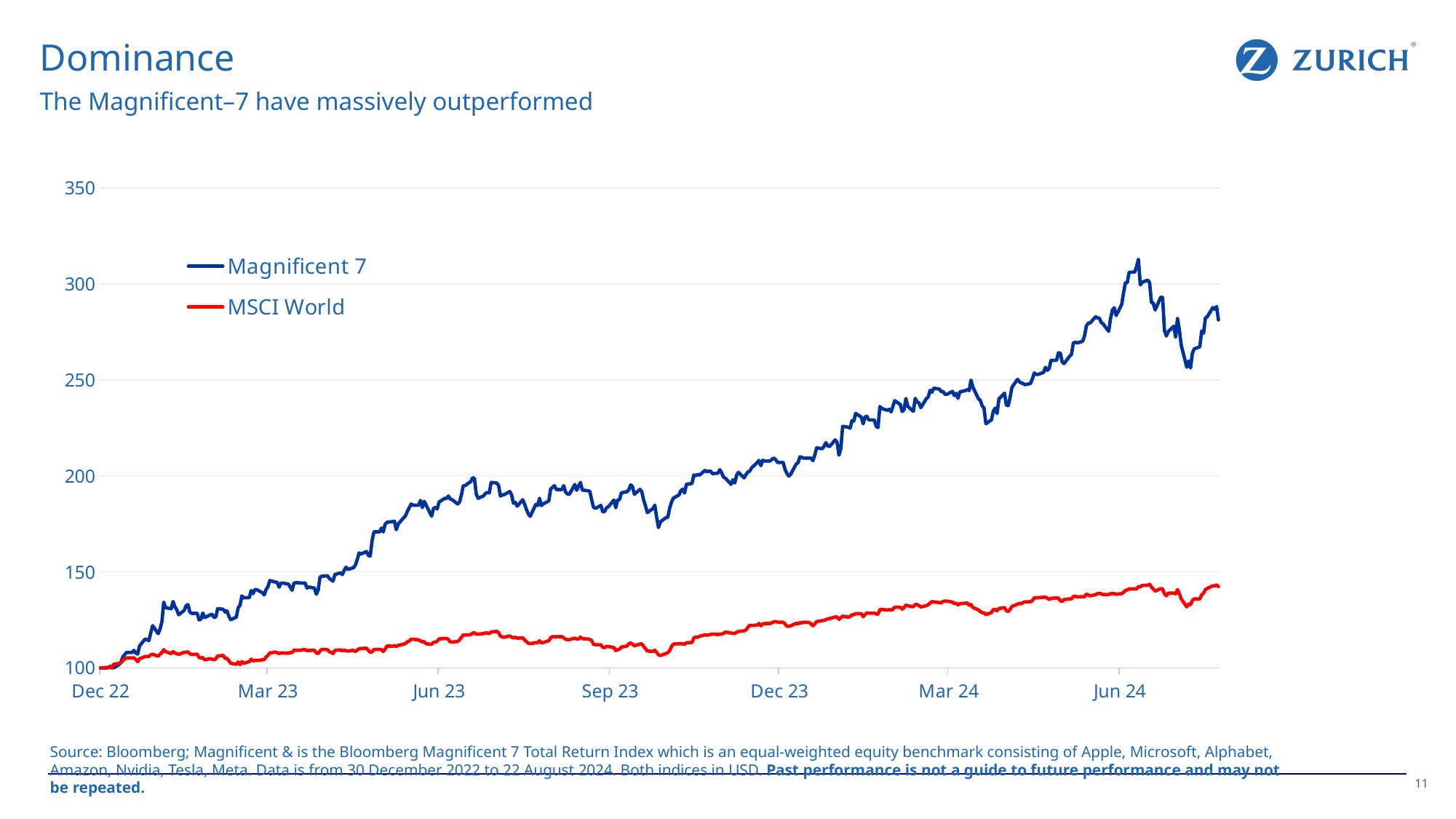
What kind of chart is shown on the slide? line chart What is the title of the slide containing the chart? Dominance Is the value for MSCI World at Jun 24 greater or less than 150? less Is the value for Magnificent 7 at Mar 24 greater or less than 200? greater Which series is higher at the end of the chart? Magnificent 7 Does the Magnificent 7 line rise or fall overall from Dec 22 to the end of the chart? rise What are the two series named in the legend? Magnificent 7 and MSCI World How many date labels are shown on the x axis? 7 How many series does the legend list? 2 Which series is higher at Jun 24, Magnificent 7 or MSCI World? Magnificent 7 Is the value for Magnificent 7 at Jun 24 greater or less than 250? greater Does the MSCI World line rise or fall overall from Dec 22 to the end of the chart? rise